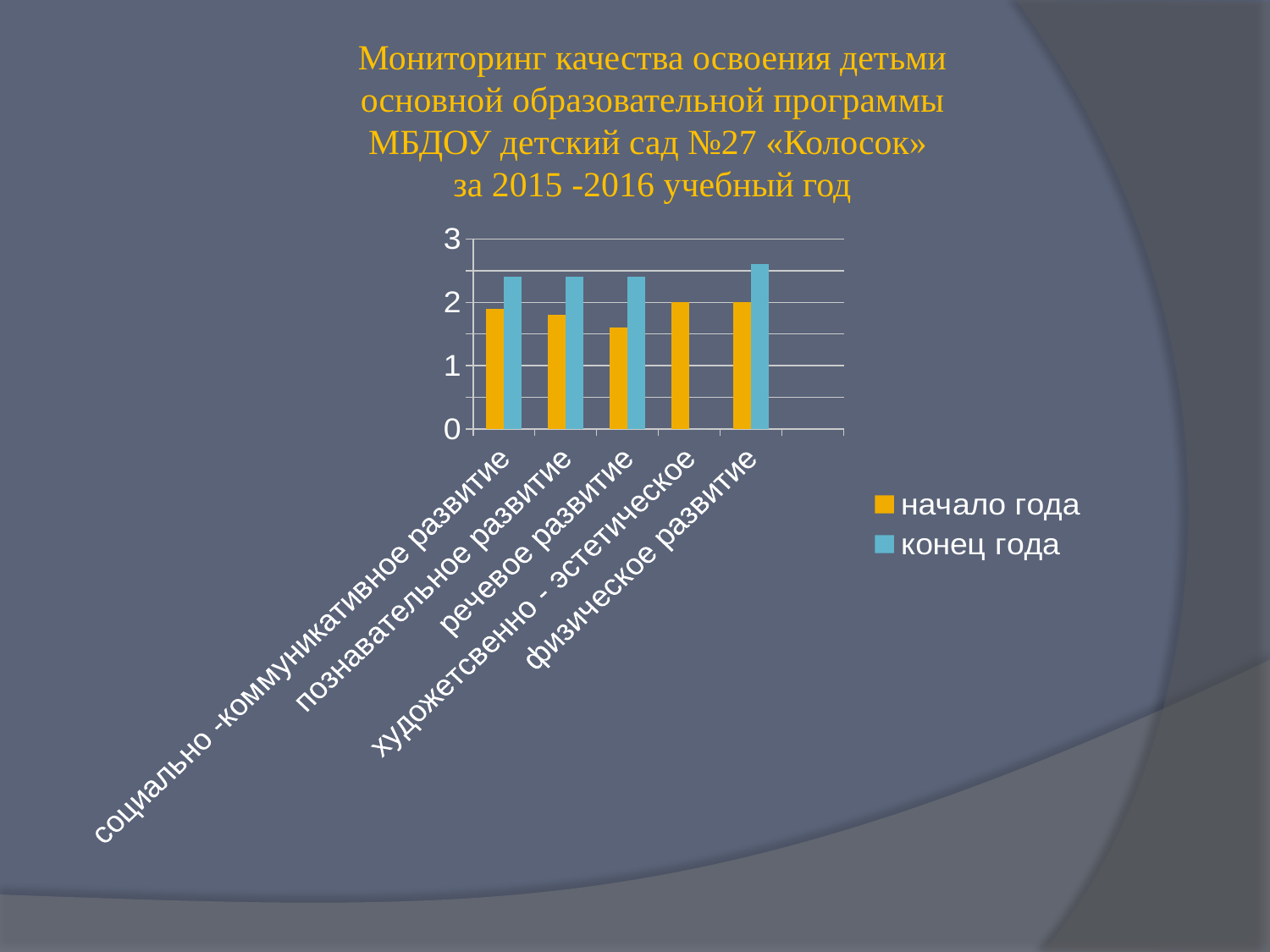
What kind of chart is shown on the slide? bar chart What are the two series named in the chart legend? начало года, конец года Which category has the lowest value for начало года? речевое развитие How many categories are shown on the x axis of the chart? 5 Is the value for начало года in речевое развитие greater or less than 2? less For речевое развитие, which is larger: начало года or конец года? конец года Is the value for конец года in физическое развитие greater or less than 3? less Which category has the highest value for конец года? физическое развитие Which category has no конец года bar shown in the chart? художетсвенно - эстетическое Is the value for конец года in социально-коммуникативное развитие greater or less than 2? greater For познавательное развитие, which is larger: начало года or конец года? конец года How many series does the chart legend list? 2